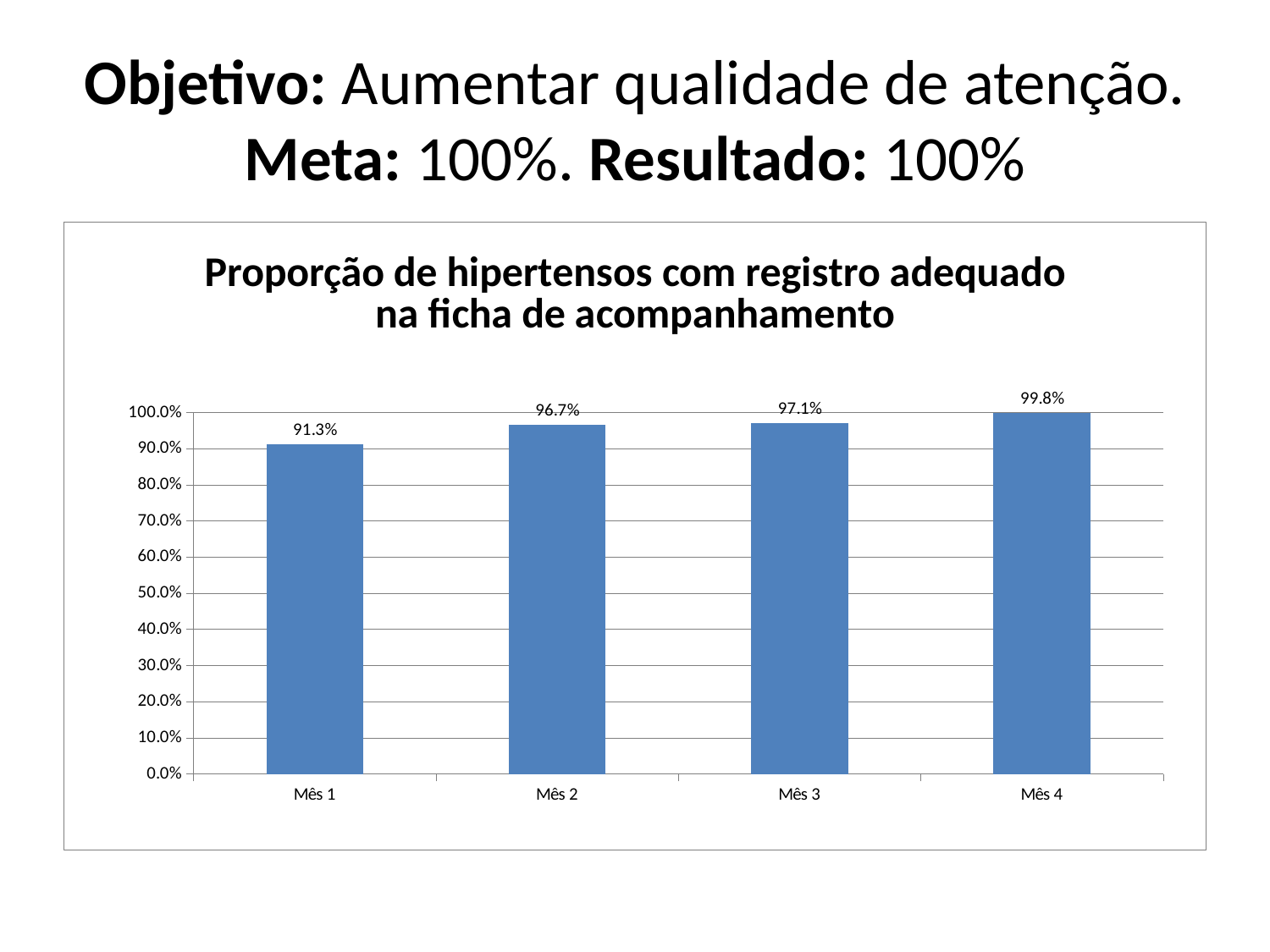
Which month has the lowest value? Mês 1 Which is larger, the value for Mês 2 or the value for Mês 1? Mês 2 Do the values rise or fall from Mês 1 to Mês 4? rise What is the value for Mês 4? 99.8% What is the value for Mês 3? 97.1% What kind of chart is shown? bar chart What is the difference between the values for Mês 2 and Mês 1? 5.4% What is the value for Mês 1? 91.3% Is the value for Mês 1 greater or less than 90.0%? greater What is the difference between the values for Mês 4 and Mês 1? 8.5% How many months are shown on the x axis? 4 Which month has the highest value? Mês 4